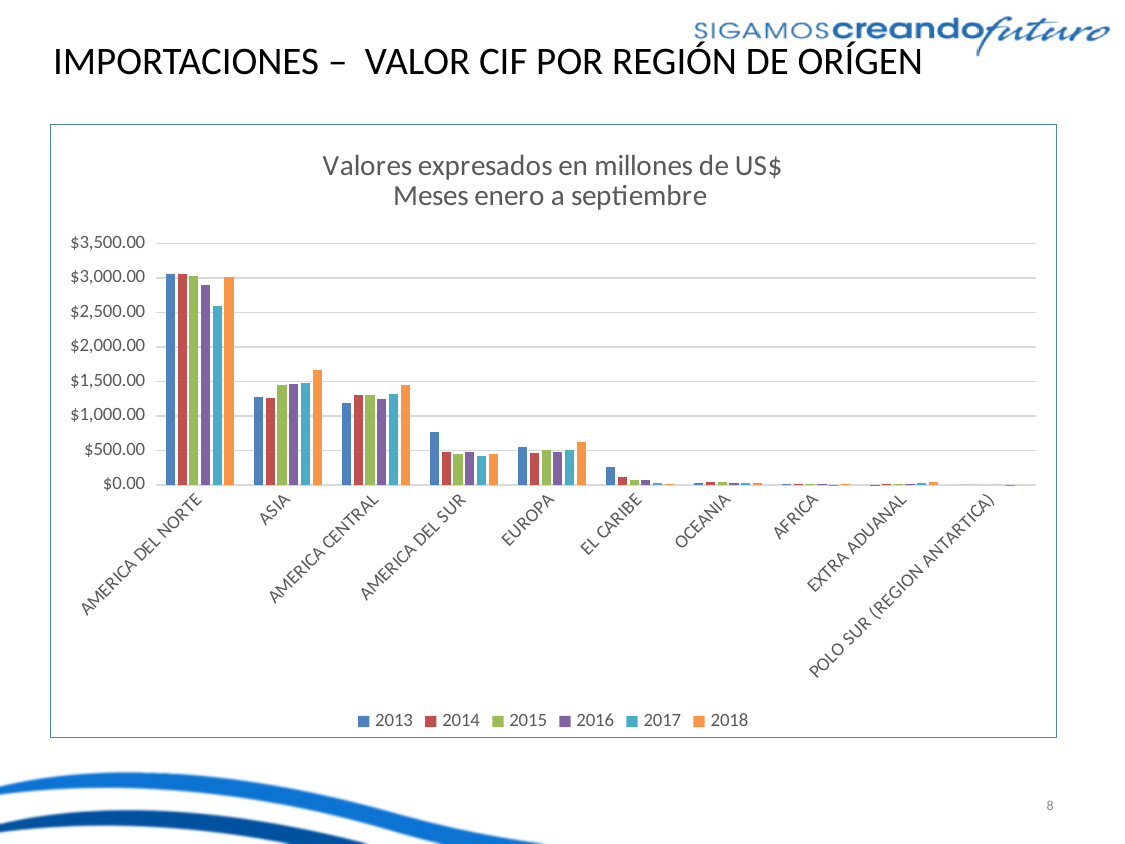
How many series does the legend list? 6 What is the first line of the chart title? Valores expresados en millones de US$ Which region has the highest import values? AMERICA DEL NORTE Do the values generally rise or fall moving from left to right across the regions? fall What kind of chart is shown on the slide? Bar chart Is the 2013 value for EL CARIBE greater or less than $500.00? less Is the 2013 value for AMERICA DEL SUR greater or less than $500.00? greater Which is larger for 2018: the value for ASIA or the value for AMERICA CENTRAL? ASIA Is the 2018 value for ASIA greater or less than $1,500.00? greater Which region has the lowest import values? POLO SUR (REGION ANTARTICA) How many regions (categories) are shown on the x axis? 10